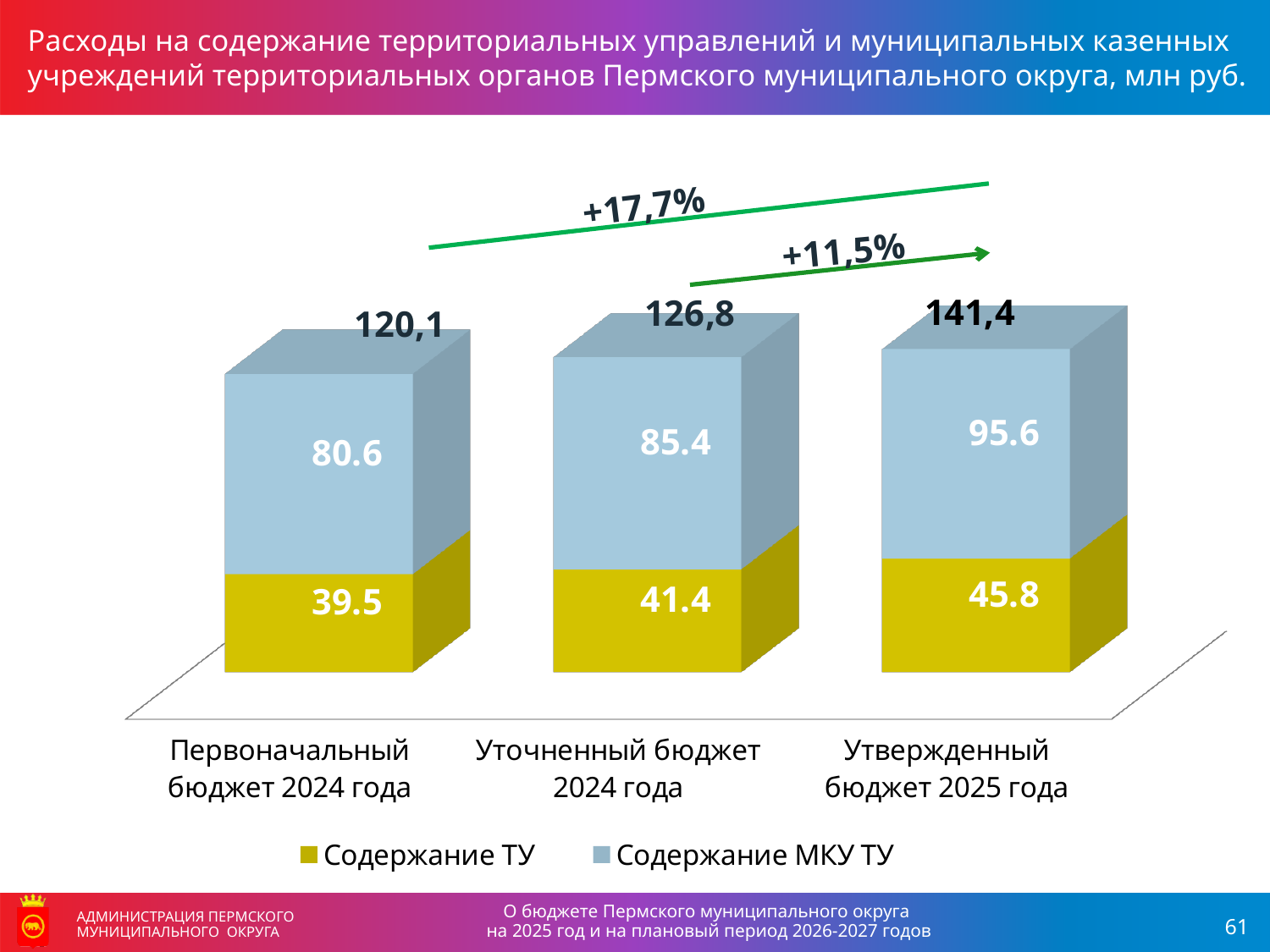
What is the value of Содержание МКУ ТУ for Утвержденный бюджет 2025 года? 95.6 What is the value of Содержание МКУ ТУ for Уточненный бюджет 2024 года? 85.4 Do the totals rise or fall from Первоначальный бюджет 2024 года to Утвержденный бюджет 2025 года? Rise What is the difference between Содержание МКУ ТУ for Утвержденный бюджет 2025 года and for Первоначальный бюджет 2024 года? 15.0 What is the total of the stacked bar for Утвержденный бюджет 2025 года? 141,4 How many series does the legend list? 2 How many categories are shown on the x axis of the chart? 3 Which category has the lowest total? Первоначальный бюджет 2024 года What type of chart is shown on the slide? Stacked bar chart What is the value of Содержание ТУ for Первоначальный бюджет 2024 года? 39.5 Which category has the highest value for Содержание ТУ? Утвержденный бюджет 2025 года What percentage change is shown between Уточненный бюджет 2024 года and Утвержденный бюджет 2025 года? +11,5%